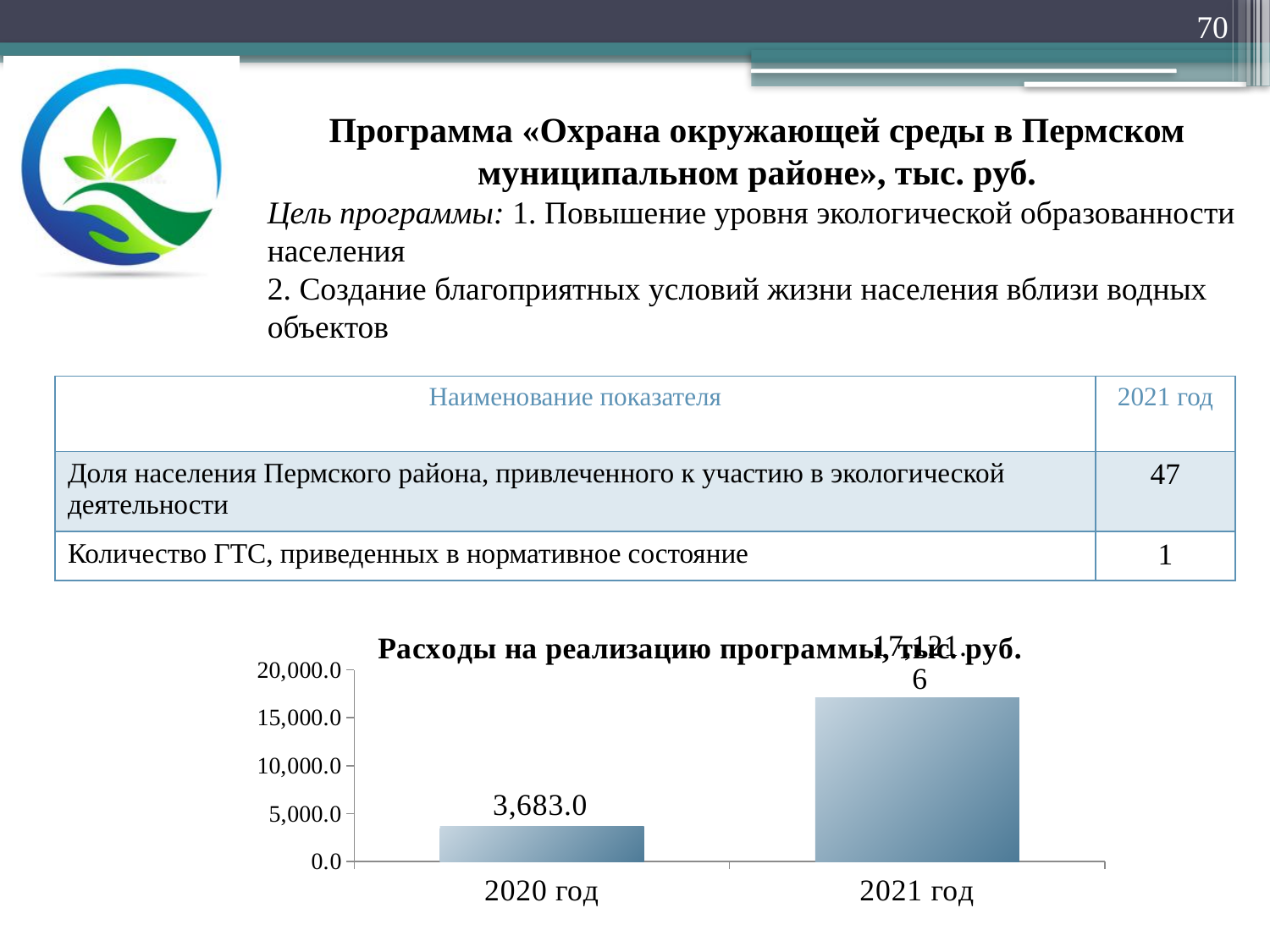
What is the title of the chart on the slide? Расходы на реализацию программы, тыс. руб. Do the values in the chart "Расходы на реализацию программы, тыс. руб." rise or fall from 2020 год to 2021 год? rise What is the highest tick value shown on the y axis of the chart "Расходы на реализацию программы, тыс. руб."? 20,000.0 Which year has the highest value in the chart "Расходы на реализацию программы, тыс. руб."? 2021 год Is the value for 2020 год in the chart "Расходы на реализацию программы, тыс. руб." greater or less than 5,000.0? less Is the value for 2021 год in the chart "Расходы на реализацию программы, тыс. руб." greater or less than 15,000.0? greater Which year has the lowest value in the chart "Расходы на реализацию программы, тыс. руб."? 2020 год How many categories are shown on the x axis of the chart "Расходы на реализацию программы, тыс. руб."? 2 What is the value for 2020 год in the chart "Расходы на реализацию программы, тыс. руб."? 3,683.0 What kind of chart is "Расходы на реализацию программы, тыс. руб."? bar chart In the chart "Расходы на реализацию программы, тыс. руб.", which is larger: the value for 2020 год or for 2021 год? 2021 год